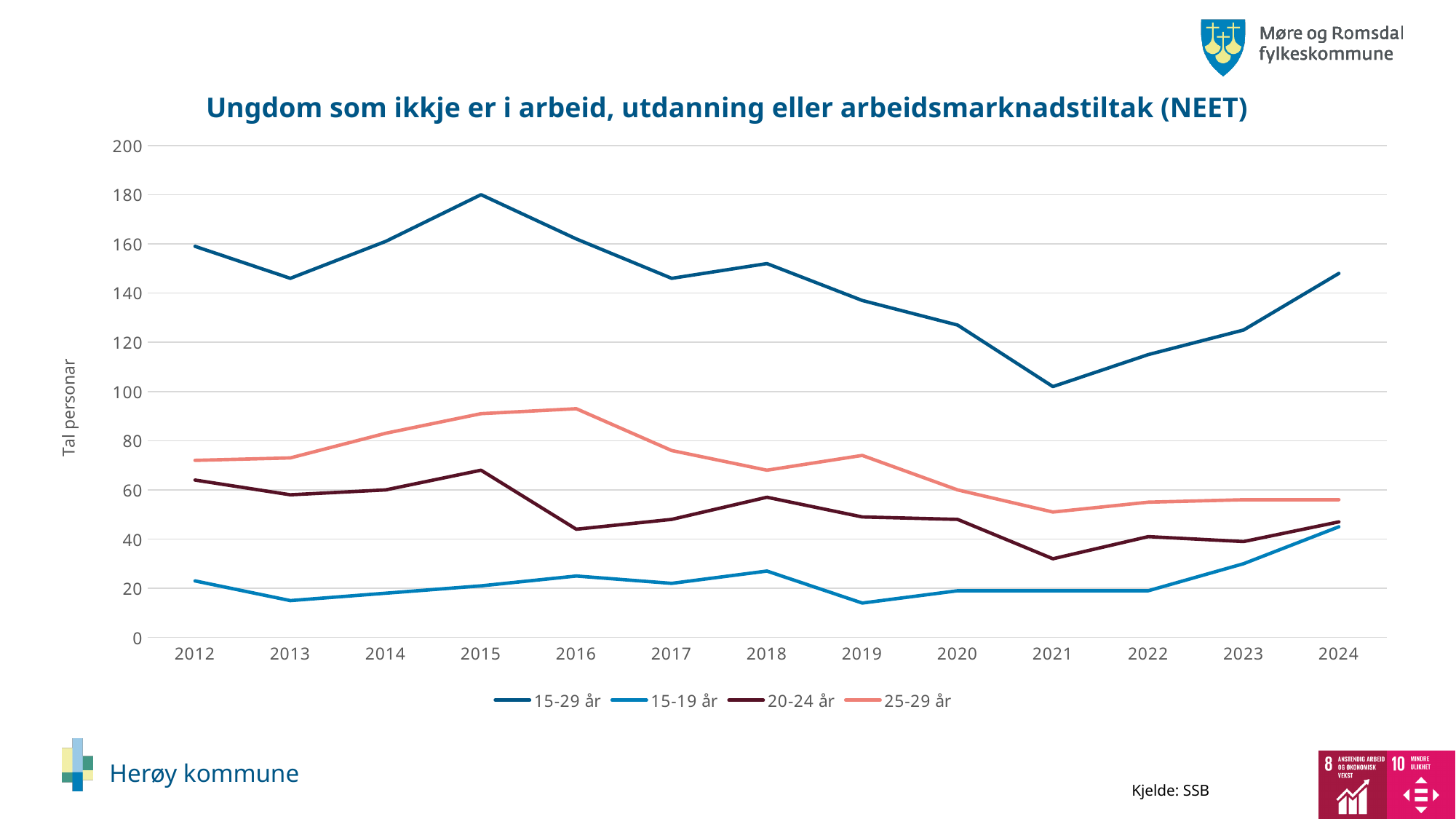
What is the label on the y axis? Tal personar In which year does the 20-24 år series reach its lowest value? 2021 What kind of chart is shown on the slide? line chart How many years are shown on the x axis? 13 Does the 15-29 år series rise or fall from 2021 to 2024? rise In which year does the 15-29 år series reach its lowest value? 2021 Is the value for 15-29 år in 2021 greater or less than 120? less Is the value for 20-24 år in 2021 greater or less than 40? less How many series does the legend list? 4 Which is larger for the 15-29 år series: the value in 2012 or the value in 2024? 2012 In which year does the 15-29 år series reach its highest value? 2015 Is the value for 25-29 år in 2016 greater or less than 80? greater